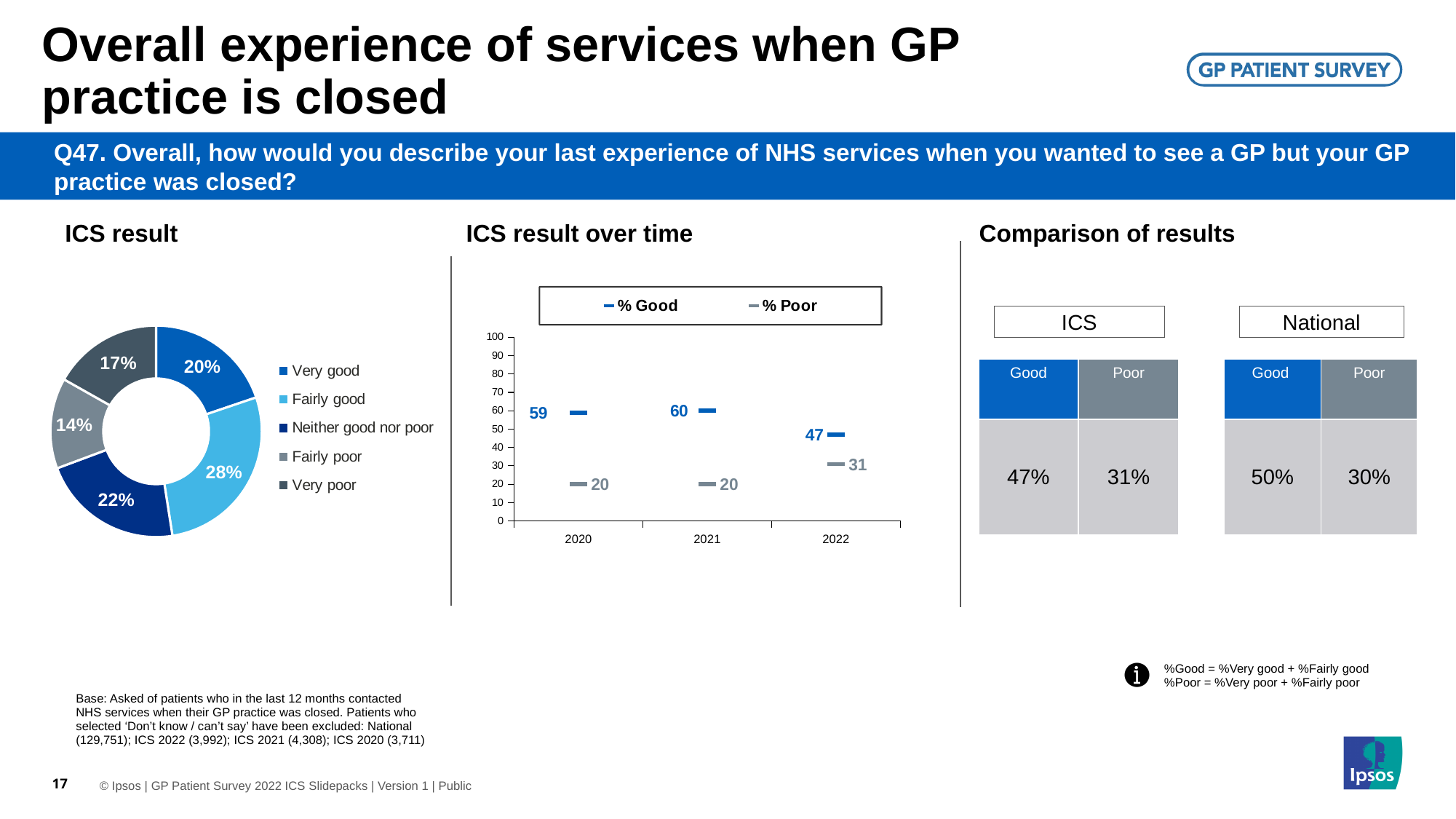
In the 'ICS result' chart, what percentage of patients said 'Very poor'? 17% What kind of chart is the 'ICS result' chart? Donut chart In the 'ICS result over time' chart, did the % Good value rise or fall between 2021 and 2022? Fall In the 'ICS result over time' chart, how many series does the legend list? 2 In the 'ICS result' chart, how many categories does the legend list? 5 In the 'ICS result' chart, which category has the largest share? Fairly good In the 'ICS result' chart, which category has the smallest share? Fairly poor In the 'ICS result over time' chart, what is the % Good value for 2022? 47 In the 'ICS result over time' chart, what is the % Poor value for 2021? 20 In the 'ICS result over time' chart, what is the difference between the % Good and % Poor values in 2020? 39 In the 'ICS result' chart, what is the difference between the 'Neither good nor poor' share and the 'Very good' share? 2% In the 'ICS result' chart, what percentage of patients said 'Fairly good'? 28%